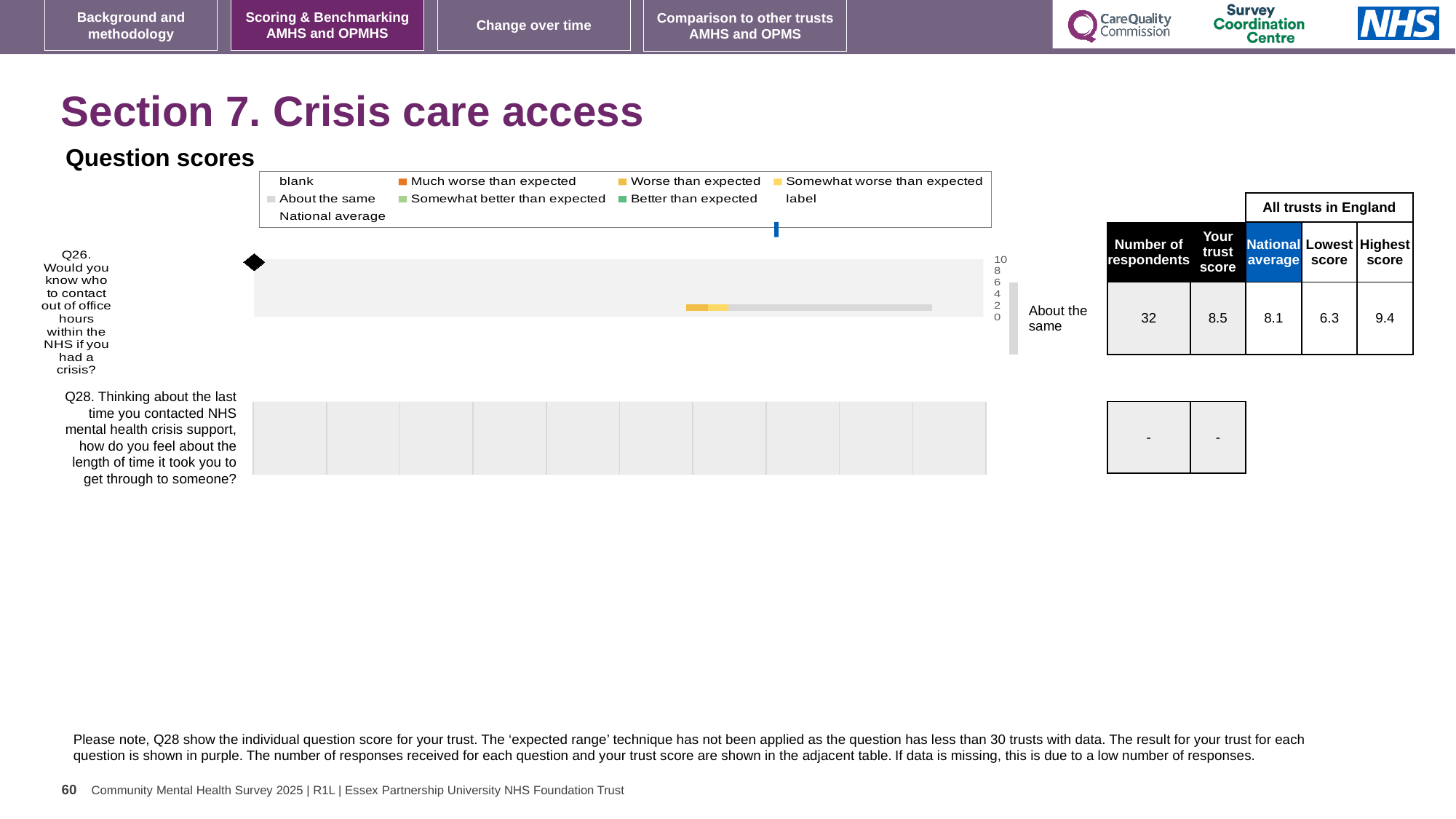
What kind of chart is used to show the question scores on this slide? bar chart According to the table beside the chart, what is the highest score among all trusts in England for Q26? 9.4 For Q26, what is the difference between the trust score and the national average? 0.4 For Q26, which is larger: the trust score or the national average? the trust score According to the table beside the chart, how many respondents answered Q26? 32 What benchmark category is shown next to the Q26 bar in the chart? About the same How many questions are plotted in the question scores chart? 2 What is the highest value shown on the score axis of the question scores chart? 10 According to the table beside the chart, what is the national average for Q26? 8.1 According to the table beside the chart, what is the lowest score among all trusts in England for Q26? 6.3 According to the table beside the chart, what is the trust score for Q26? 8.5 Which questions are plotted in the question scores chart? Q26 and Q28